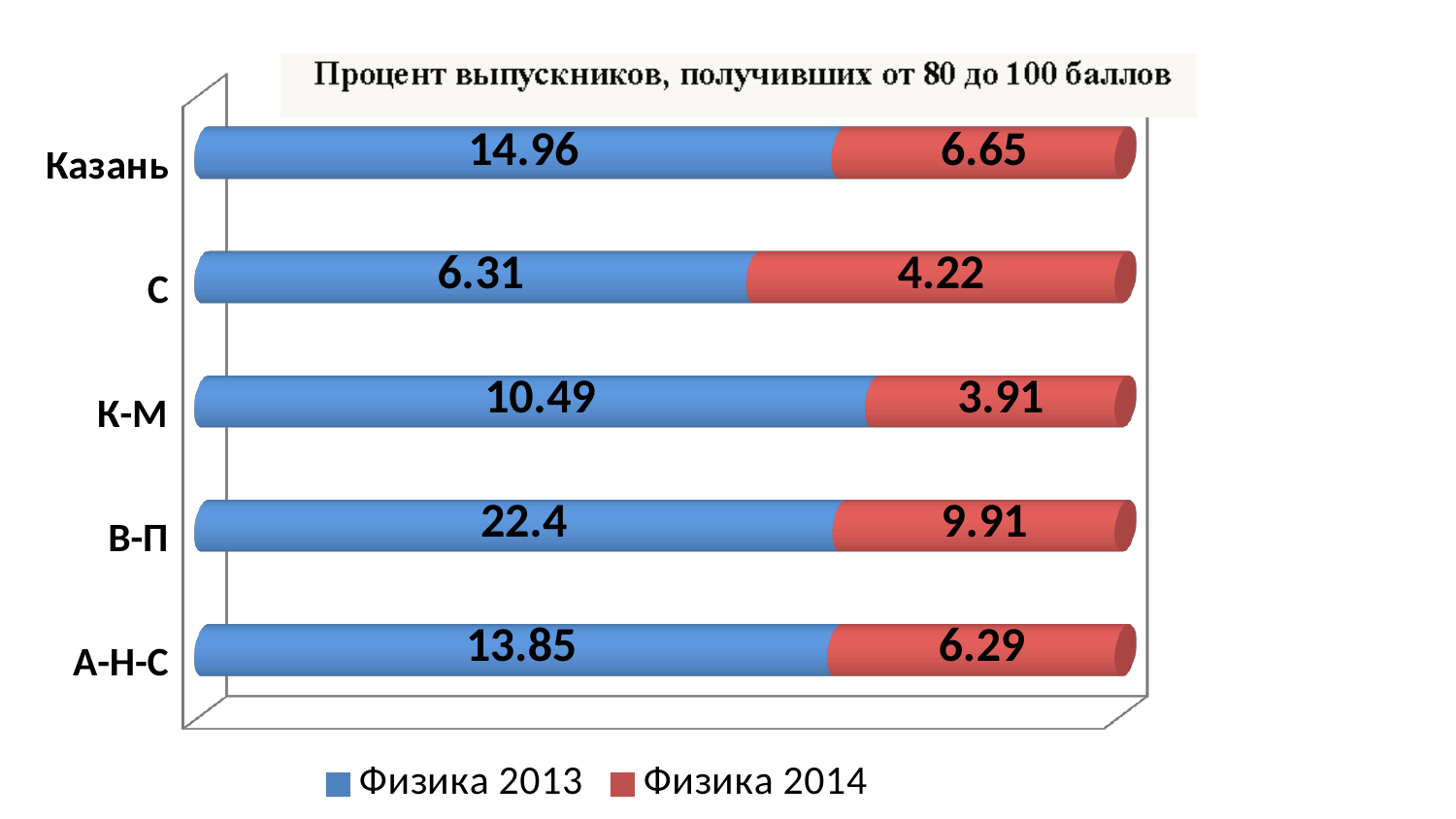
What is the value for Физика 2013 for А-Н-С? 13.85 How many categories are shown on the chart? 5 How many series does the legend list? 2 What is the value for Физика 2013 for Казань? 14.96 What kind of chart is shown on the slide? Stacked bar chart What is the title of the chart? Процент выпускников, получивших от 80 до 100 баллов Which category has the highest value for Физика 2013? В-П What is the difference between the Физика 2013 and Физика 2014 values for В-П? 12.49 Which category has the lowest value for Физика 2013? С Which is larger: the Физика 2014 value for Казань or the Физика 2014 value for С? Казань Which category has the lowest value for Физика 2014? К-М What is the value for Физика 2014 for К-М? 3.91